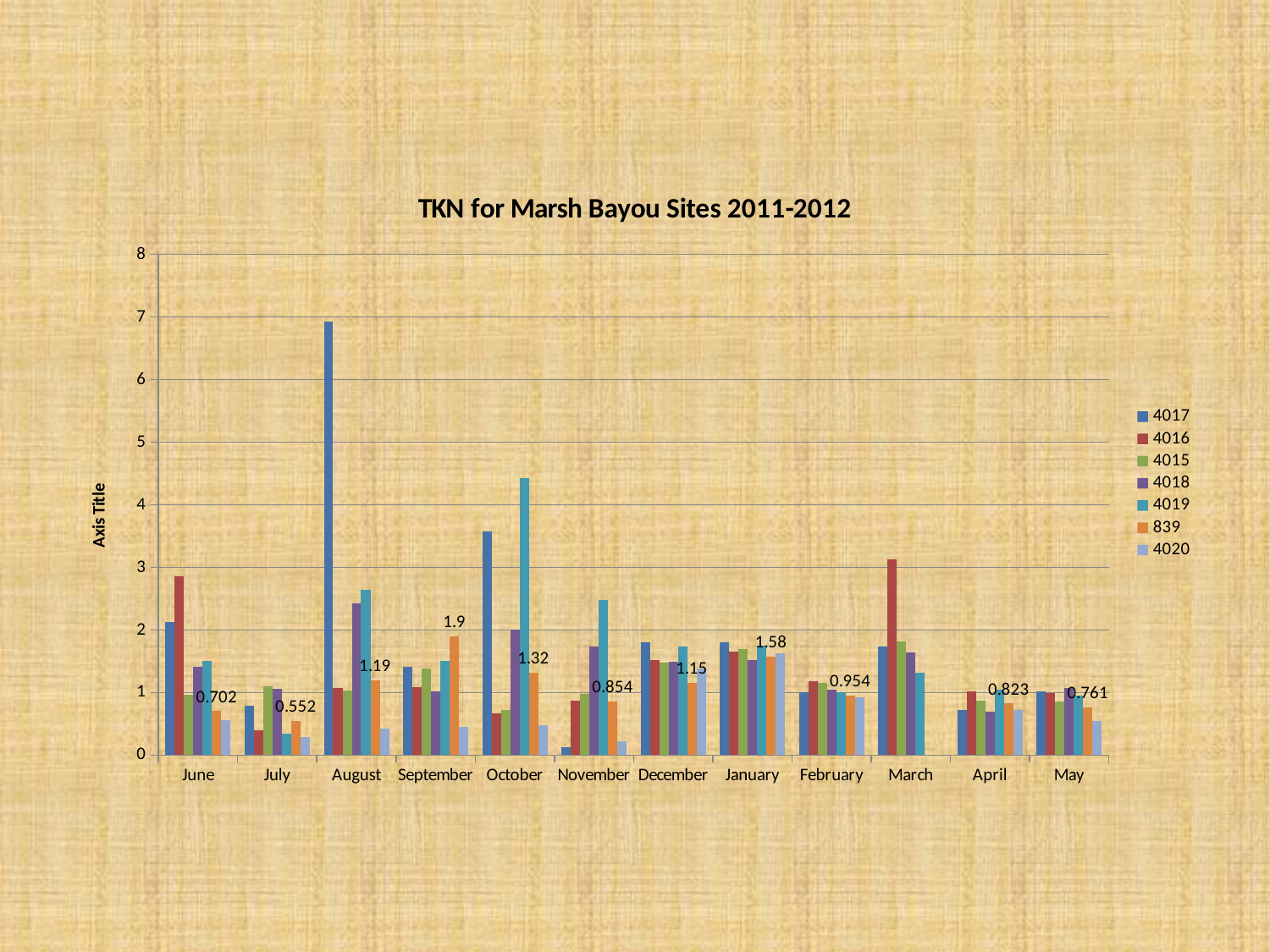
How many months are shown on the x axis? 12 What is the value for site 839 in September? 1.9 Is the value for site 4017 in August greater or less than 6? greater In which month is the value for site 839 highest? September Which is larger for site 839: the value in January or the value in December? January Is the value for site 4019 in October greater or less than 4? greater How many series does the legend list? 7 In which month is the value for site 839 lowest? July What is the difference between the site 839 values in September and July? 1.348 What kind of chart is shown on the slide? bar chart What is the value for site 839 in January? 1.58 What is the value for site 839 in June? 0.702